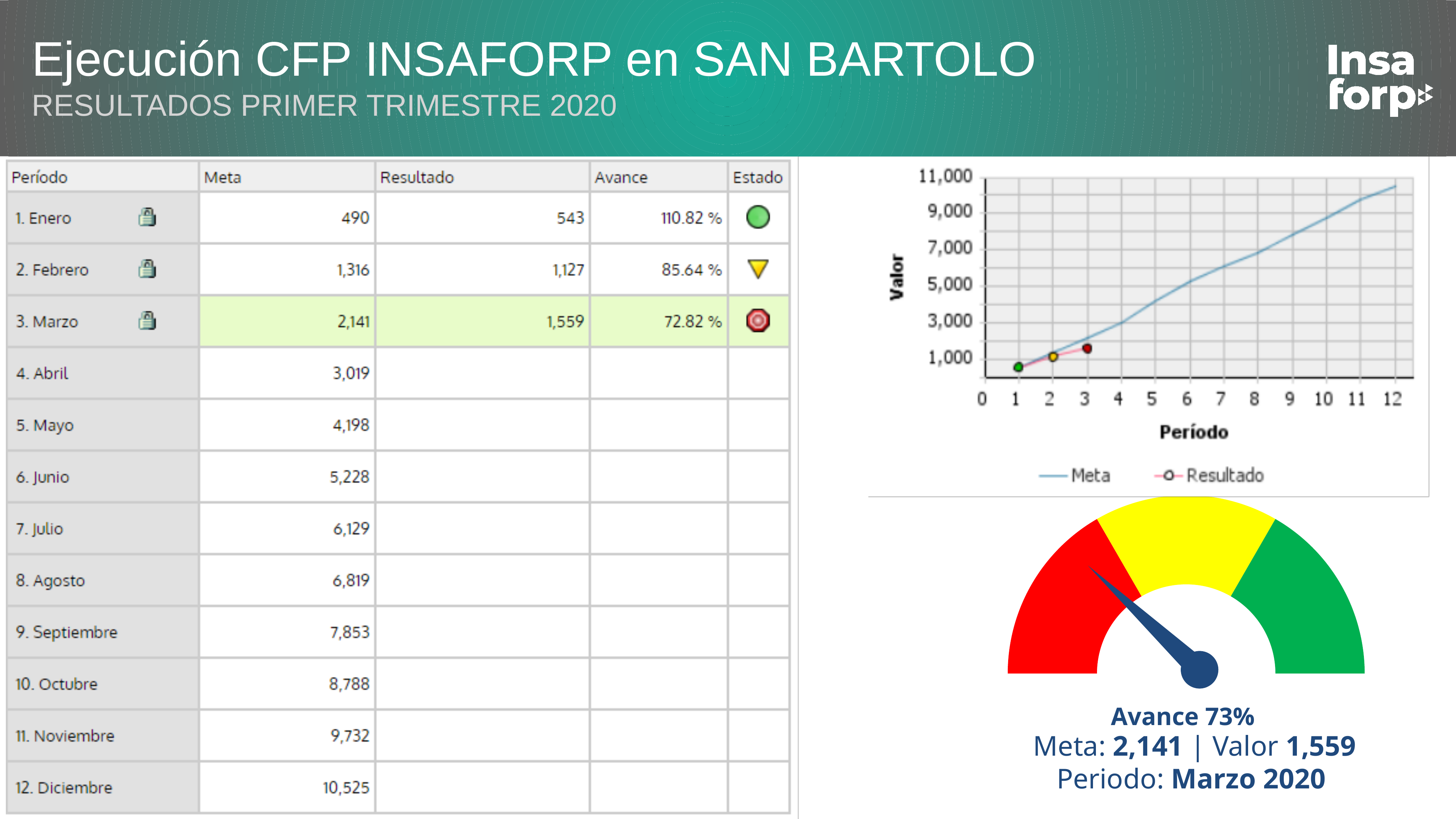
In the gauge chart at the bottom right, what Avance percentage is shown? 73% In the line chart, is the Meta value at period 1 greater or less than 1,000? less In the gauge chart at the bottom right, what is the Meta value shown? 2,141 In the line chart, is the Meta value at period 12 greater or less than 9,000? greater In the line chart, how many points are plotted for the Resultado series? 3 In the line chart, does the Meta series rise or fall as the period increases from 1 to 12? rises What kind of chart is the chart at the top right of the slide? line chart In the line chart, what are the names of the two series in the legend? Meta and Resultado In the line chart, is the Resultado value at period 3 greater or less than 1,000? greater In the line chart, how many series does the legend list? 2 In the gauge chart at the bottom right, what is the difference between the Meta (2,141) and the Valor (1,559)? 582 In the line chart, what is the label of the y axis? Valor